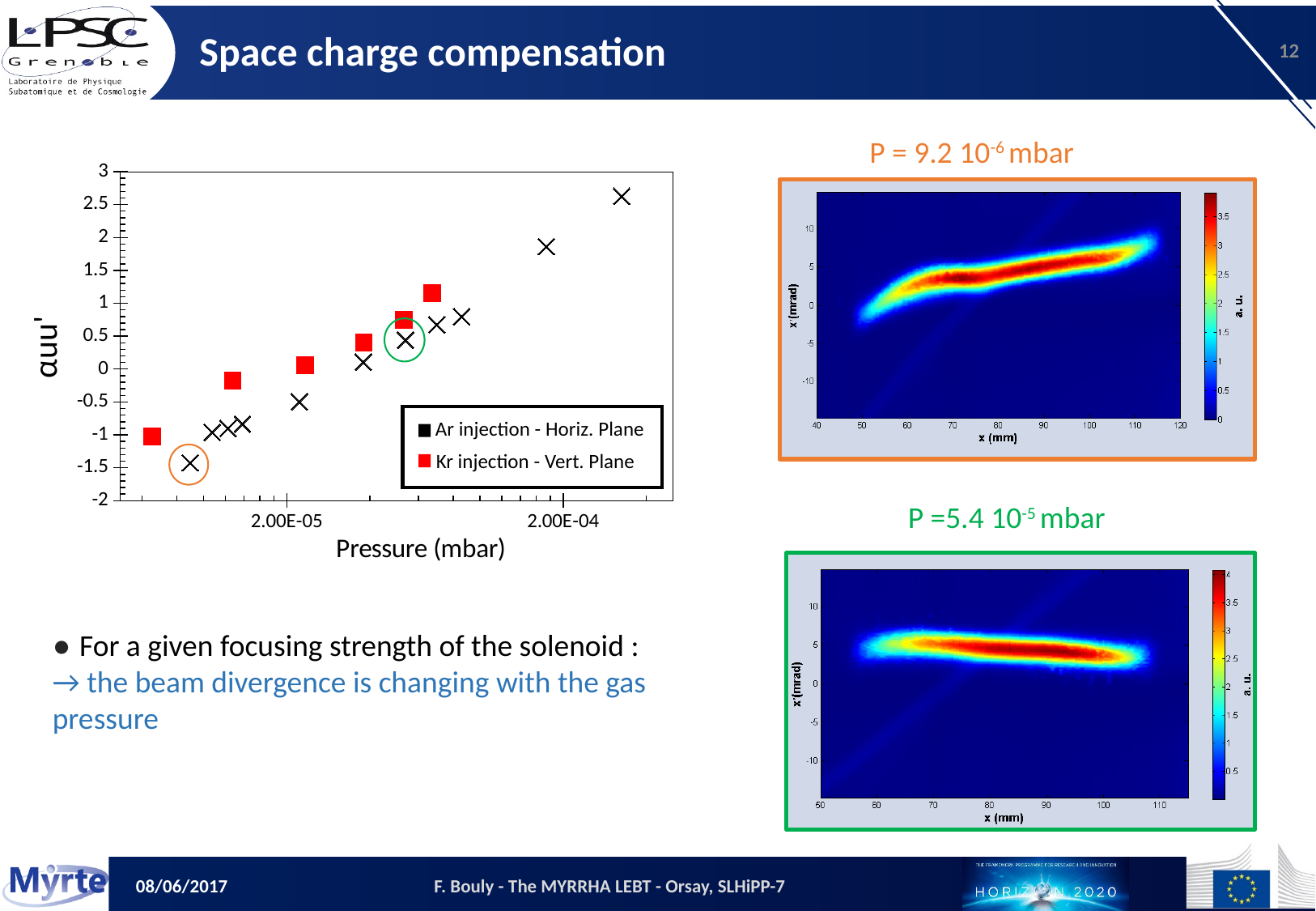
How many series does the legend of the scatter chart list? 2 What is the x-axis title of the scatter chart? Pressure (mbar) Is the highest value of the Kr injection - Vert. Plane series greater or less than 1? greater Is the lowest value of the Ar injection - Horiz. Plane series greater or less than -1? less Do the values of the Kr injection - Vert. Plane series rise or fall as pressure increases along the x axis? rise Which series reaches the higher maximum value on the scatter chart, Ar injection - Horiz. Plane or Kr injection - Vert. Plane? Ar injection - Horiz. Plane What are the two series named in the legend of the scatter chart? Ar injection - Horiz. Plane; Kr injection - Vert. Plane Is the highest value of the Ar injection - Horiz. Plane series greater or less than 2? greater Do the values of the Ar injection - Horiz. Plane series rise or fall as pressure increases along the x axis? rise How many red square markers (Kr injection - Vert. Plane) are plotted on the scatter chart? 6 What kind of chart is shown on the left of the slide? scatter chart